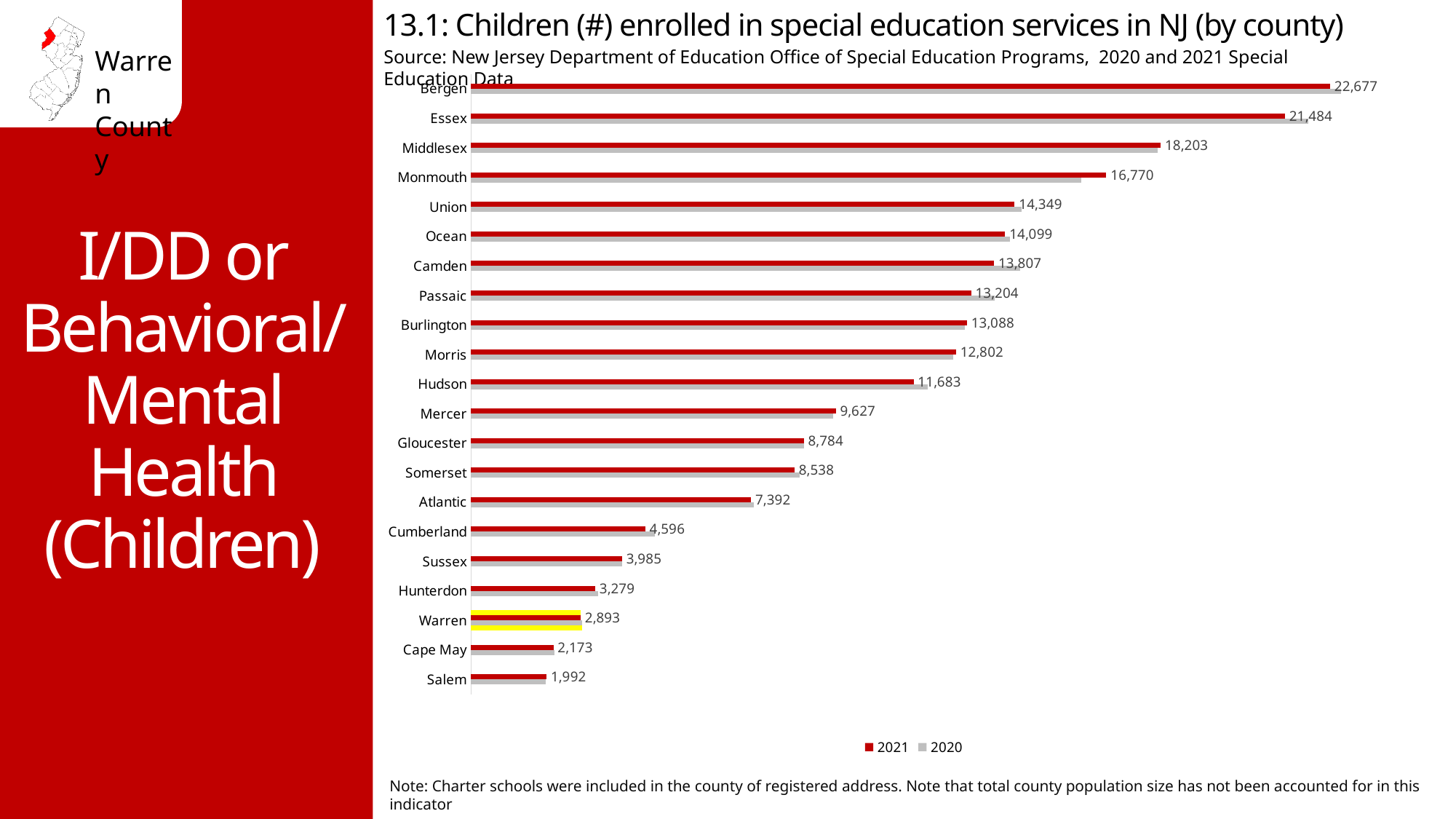
What is the 2021 value for Bergen County? 22,677 What is the difference between the 2021 values for Warren and Cape May? 720 What is the 2021 value for Warren County? 2,893 What kind of chart is shown on the slide? bar chart Which county has the lowest 2021 value? Salem What is the 2021 value for Hunterdon County? 3,279 Which county has the highest 2021 value? Bergen How many counties are shown in the chart? 21 Which has a larger 2021 value, Sussex or Cumberland? Cumberland How many series does the legend list? 2 What is the difference between the 2021 values for Bergen and Essex? 1,193 Which series is shown in red in the legend? 2021